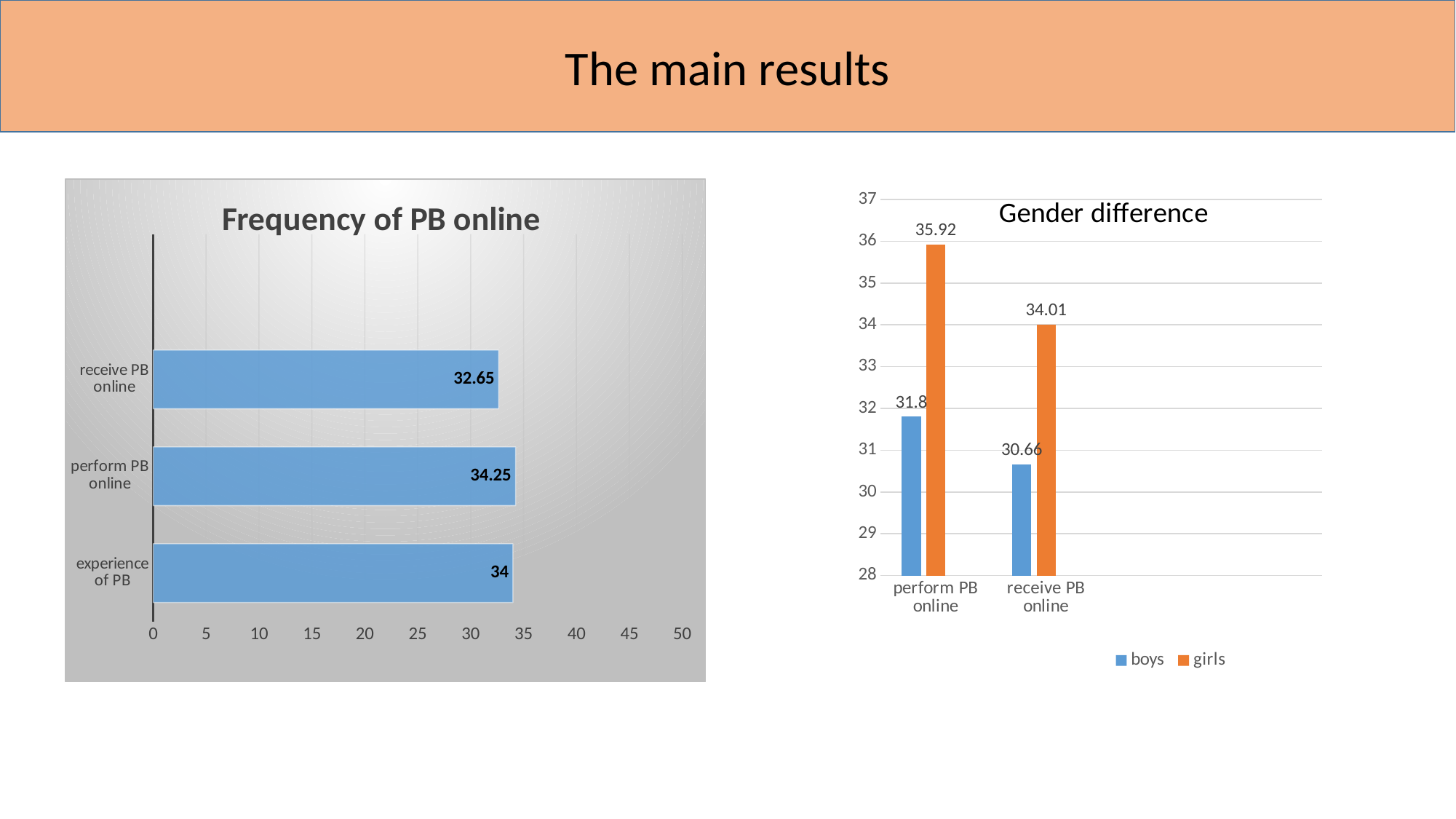
In the 'Gender difference' chart, what is the value for girls for 'perform PB online'? 35.92 In the 'Gender difference' chart, what is the value for boys for 'receive PB online'? 30.66 In the 'Frequency of PB online' chart, what is the difference between 'experience of PB' and 'receive PB online'? 1.35 In the 'Gender difference' chart, which is larger for 'perform PB online': boys or girls? girls In the 'Frequency of PB online' chart, what is the value for 'perform PB online'? 34.25 In the 'Gender difference' chart, what is the difference between girls and boys for 'receive PB online'? 3.35 What kind of chart is the 'Frequency of PB online' chart? bar chart In the 'Frequency of PB online' chart, which category has the highest value? perform PB online How many series does the legend of the 'Gender difference' chart list? 2 In the 'Frequency of PB online' chart, how many categories are shown? 3 In the 'Frequency of PB online' chart, what is the value for 'receive PB online'? 32.65 In the 'Frequency of PB online' chart, which category has the lowest value? receive PB online